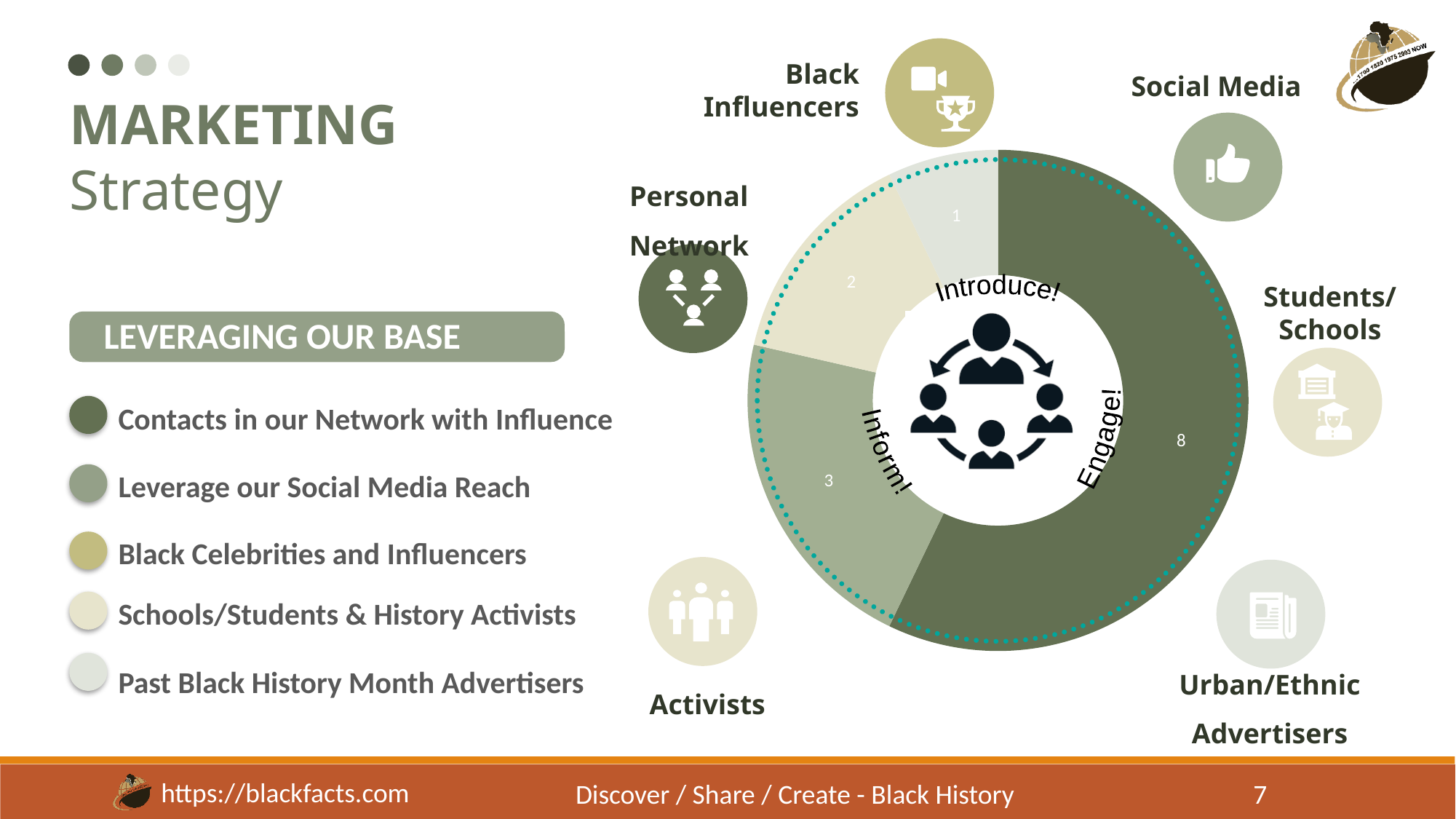
What is the difference between the segment labelled 3 and the segment labelled 1? 2 What is the difference between the segment labelled 8 and the segment labelled 3? 5 What value is shown on the light beige segment, which the legend maps to 'Schools/Students & History Activists'? 2 What three words are written around the centre of the doughnut chart? Introduce!, Engage!, Inform! What value is shown on the largest segment of the doughnut chart? 8 What kind of chart is shown on the slide? Doughnut (pie) chart What is the heading of the legend box to the left of the chart? LEVERAGING OUR BASE What value is shown on the smallest labelled segment of the doughnut chart? 1 What value is shown on the palest segment, which the legend maps to 'Past Black History Month Advertisers'? 1 What value is shown on the dark green segment, which the legend maps to 'Contacts in our Network with Influence'? 8 Which segment is larger: the one labelled 3 or the one labelled 2? The one labelled 3 What value is shown on the medium green segment, which the legend maps to 'Leverage our Social Media Reach'? 3